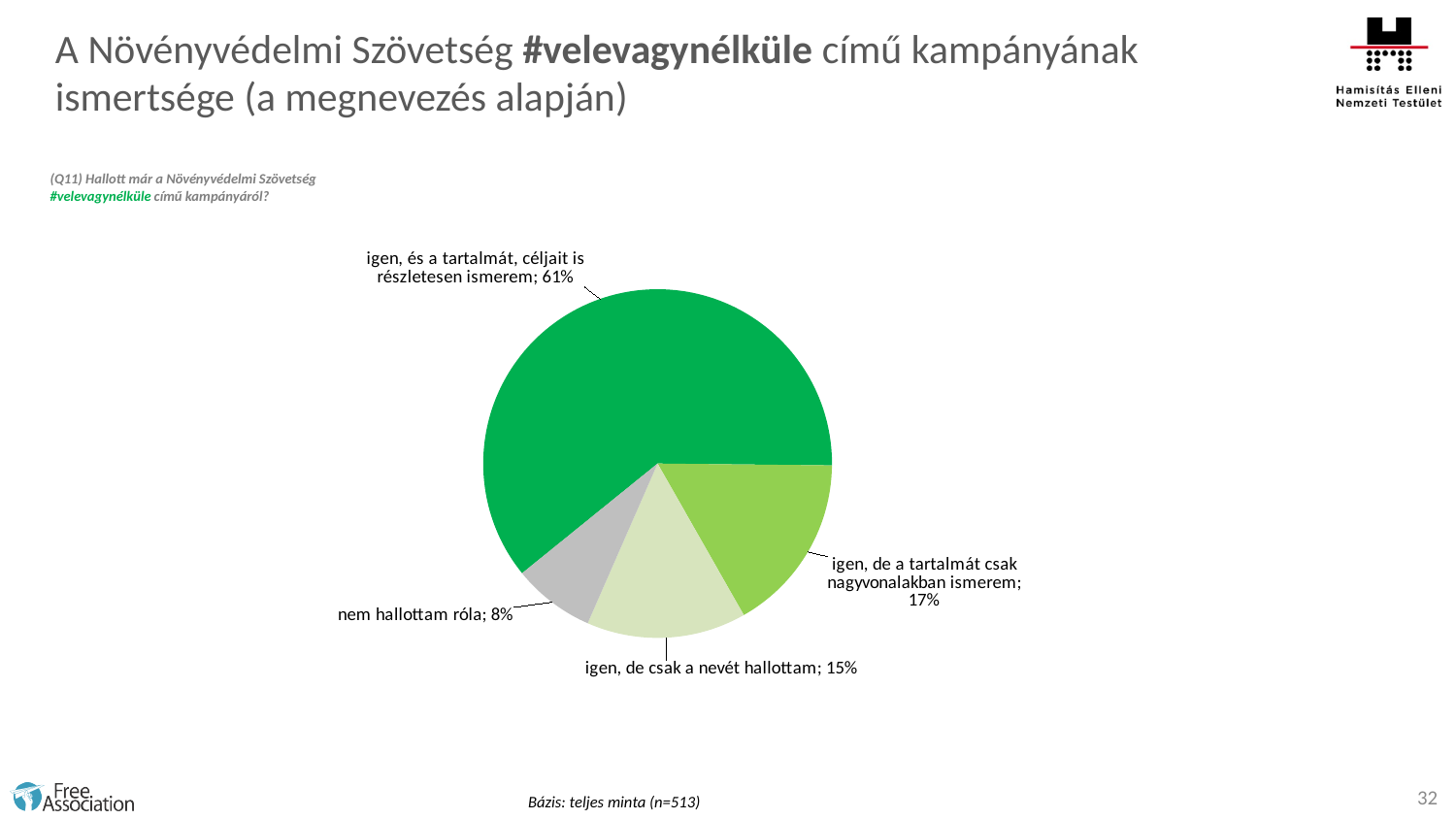
Which category has the largest slice of the pie? igen, és a tartalmát, céljait is részletesen ismerem How many slices does the pie chart have? 4 What share of respondents answered "nem hallottam róla"? 8% What share of respondents answered "igen, de a tartalmát csak nagyvonalakban ismerem"? 17% Which category has the smallest slice of the pie? nem hallottam róla What share of respondents answered "igen, és a tartalmát, céljait is részletesen ismerem"? 61% Which is larger: the share for "igen, de a tartalmát csak nagyvonalakban ismerem" or for "nem hallottam róla"? igen, de a tartalmát csak nagyvonalakban ismerem What is the difference in percentage points between "igen, és a tartalmát, céljait is részletesen ismerem" and "igen, de a tartalmát csak nagyvonalakban ismerem"? 44 What kind of chart is shown on the slide? pie chart What is the sample size (n) stated in the base note below the chart? n=513 What share of respondents answered "igen, de csak a nevét hallottam"? 15% What is the difference in percentage points between "igen, de csak a nevét hallottam" and "nem hallottam róla"? 7